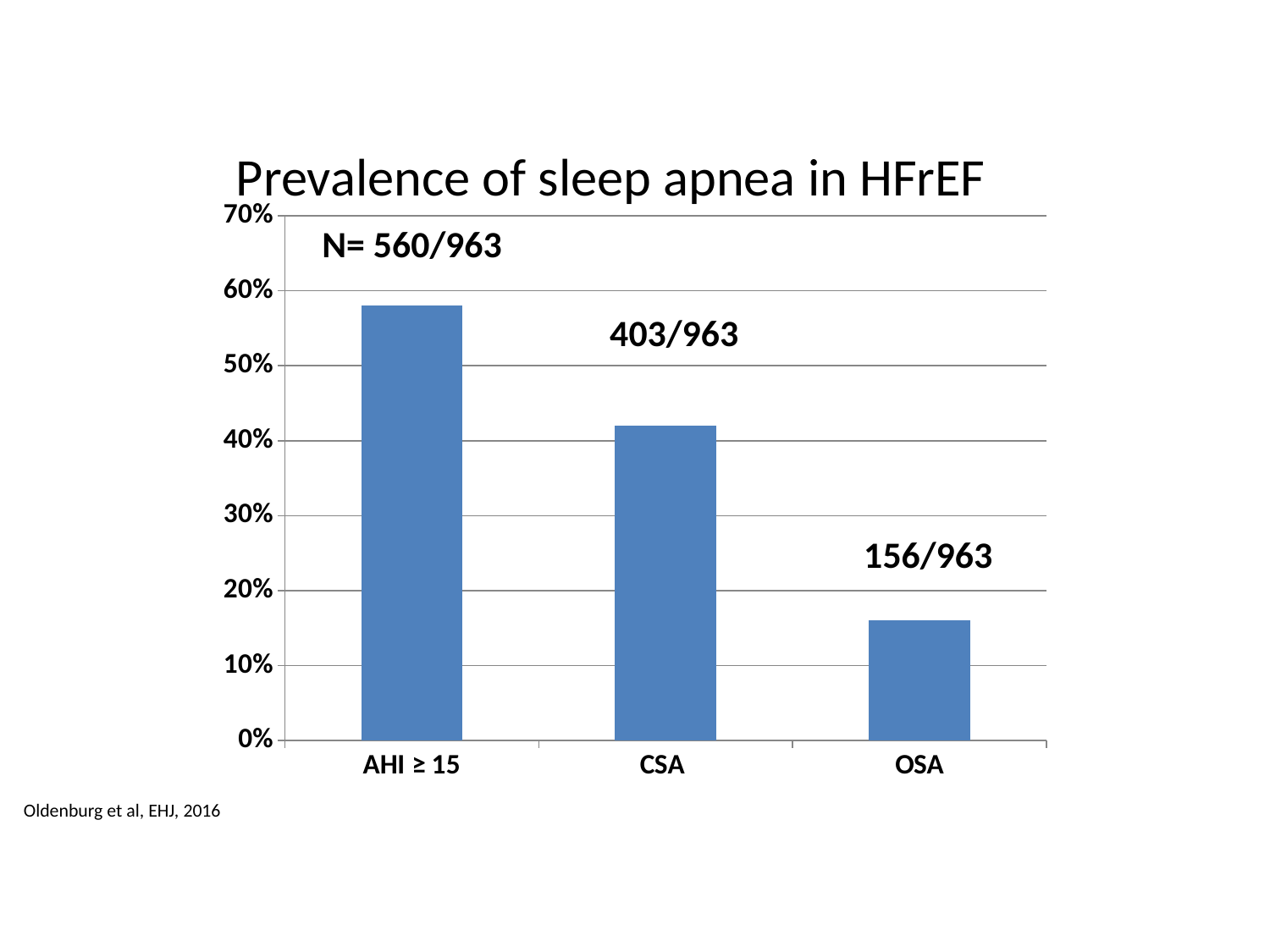
Which is larger, the value for CSA or the value for OSA? CSA Is the value for OSA greater or less than 20%? less What label is printed above the AHI ≥ 15 bar? N= 560/963 What fraction is printed above the OSA bar? 156/963 Which category has the highest bar? AHI ≥ 15 How many categories are shown on the x axis of the chart? 3 Is the value for CSA greater or less than 40%? greater What type of chart is shown on the slide? bar chart Is the value for AHI ≥ 15 greater or less than 50%? greater What is the title of the chart? Prevalence of sleep apnea in HFrEF Which category has the lowest bar? OSA What fraction is printed above the CSA bar? 403/963